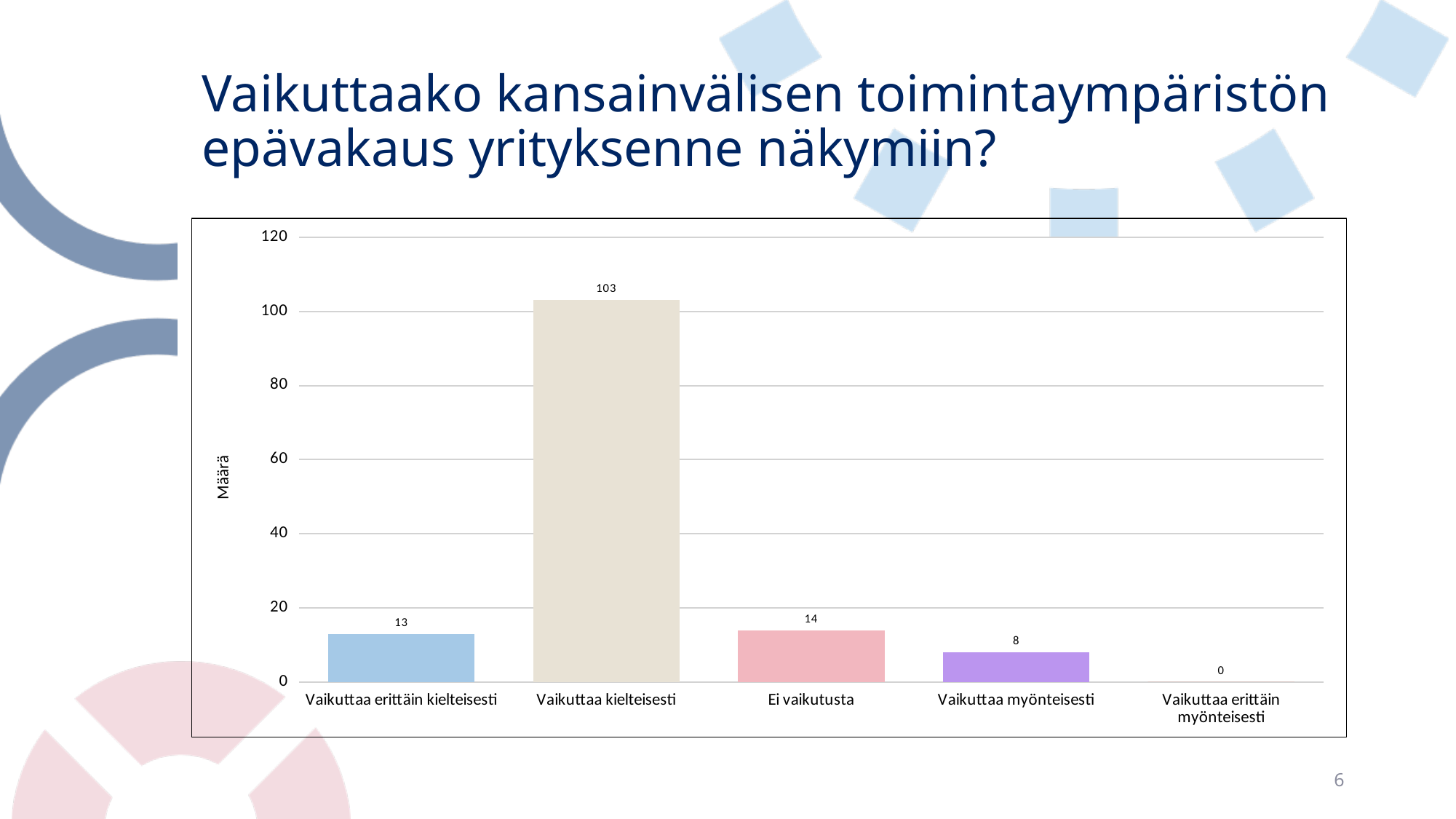
What is the difference between the values for "Vaikuttaa kielteisesti" and "Ei vaikutusta"? 89 What is the value for "Vaikuttaa erittäin kielteisesti"? 13 How many categories are shown on the x axis? 5 Is the value for "Vaikuttaa kielteisesti" greater or less than 100? greater What is the value for "Vaikuttaa kielteisesti"? 103 What is the label of the vertical axis? Määrä Which is larger, the value for "Vaikuttaa myönteisesti" or the value for "Vaikuttaa erittäin kielteisesti"? Vaikuttaa erittäin kielteisesti Which category has the highest value? Vaikuttaa kielteisesti What is the value for "Ei vaikutusta"? 14 What kind of chart is shown on the slide? bar chart What is the value for "Vaikuttaa erittäin myönteisesti"? 0 Which category has the lowest value? Vaikuttaa erittäin myönteisesti